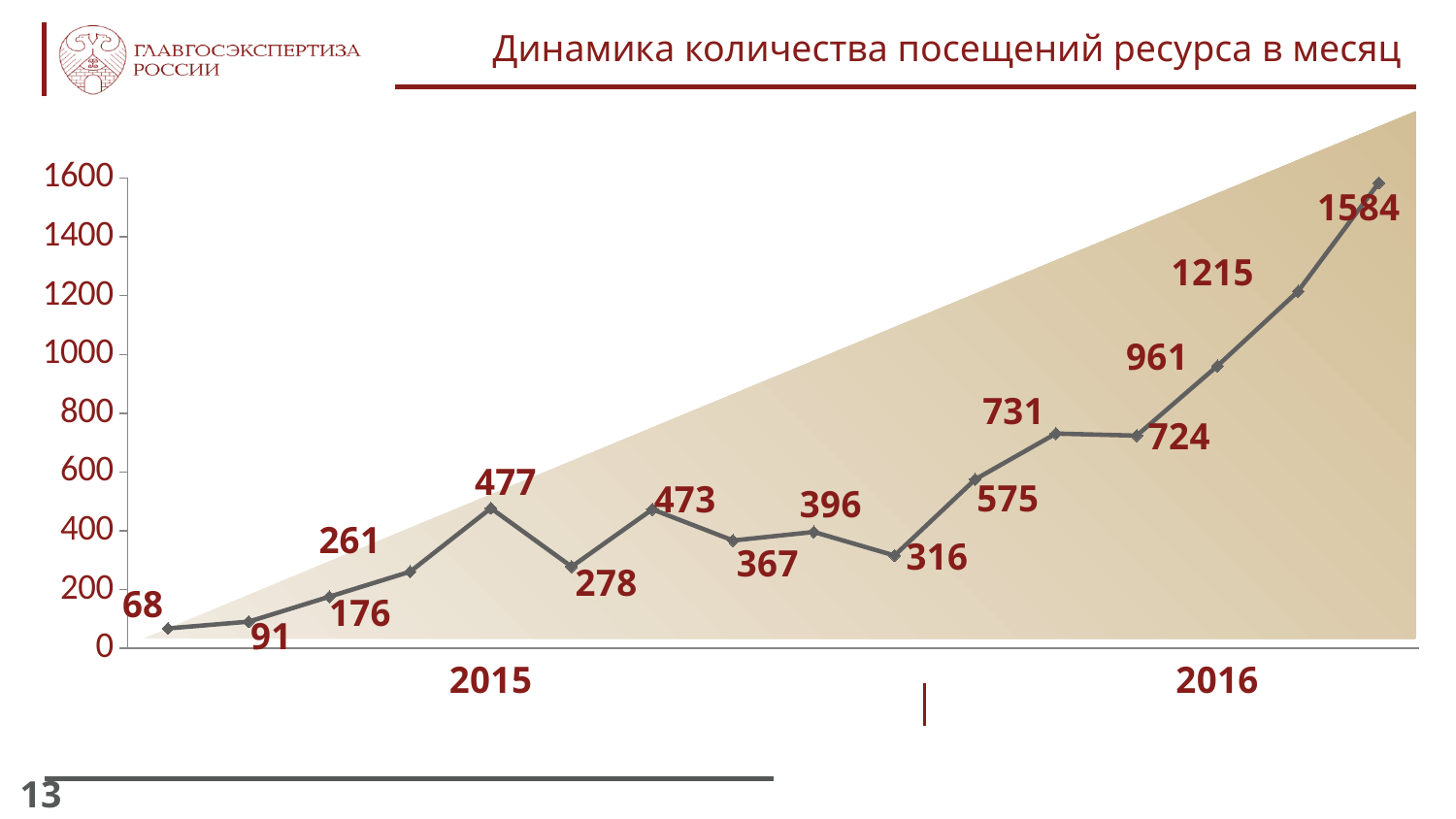
Is the highest value on the chart greater or less than 1400? greater What is the value of the first data point on the chart? 68 What is the value of the last data point on the chart? 1584 Do the values generally rise or fall from left to right along the x axis? rise What is the highest value plotted on the chart? 1584 What is the difference between the two highest values, 1584 and 1215? 369 What is the lowest value plotted on the chart? 68 What kind of chart is shown on the slide? line chart How many data points are plotted on the chart? 16 Which is larger, the value labelled 961 or the value labelled 1215? 1215 What is the title of the chart? Динамика количества посещений ресурса в месяц What is the difference between the last data point (1584) and the first data point (68)? 1516